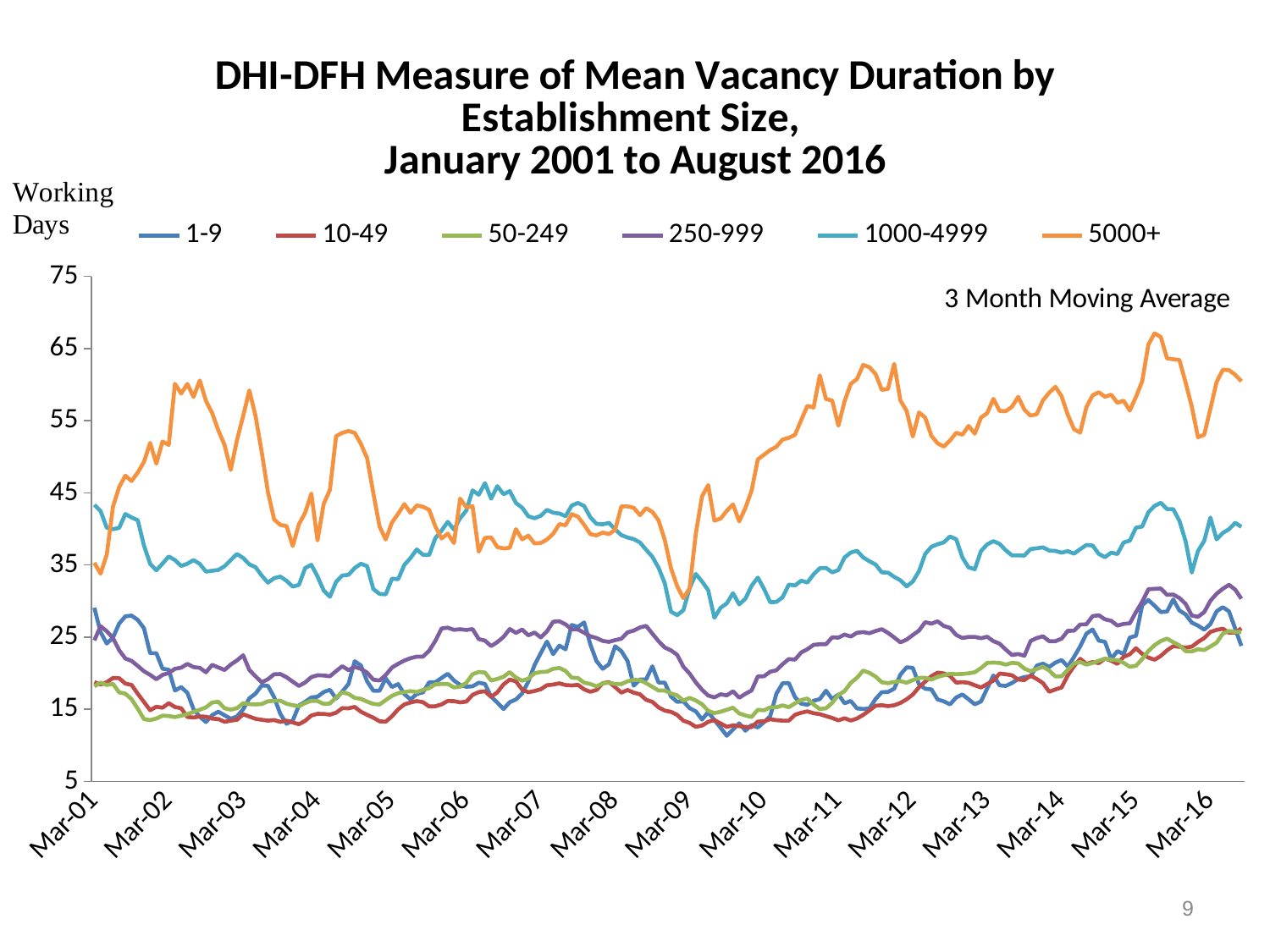
Is the value for the 5000+ series at Mar-16 greater or less than 45? greater Is the value for the 250-999 series at Mar-15 greater or less than 25? greater At Mar-16, which series is larger: 1000-4999 or 250-999? 1000-4999 What unit is shown on the vertical axis label? Working Days What are the establishment size categories listed in the legend? 1-9, 10-49, 50-249, 250-999, 1000-4999, 5000+ How many year labels are shown on the x axis? 16 Is the value for the 10-49 series at Mar-02 greater or less than 25? less Which series has the highest values at Mar-16? 5000+ How many series does the legend list? 6 Does the 5000+ series rise or fall between Mar-09 and Mar-11? rise What kind of chart is shown on the slide? line chart